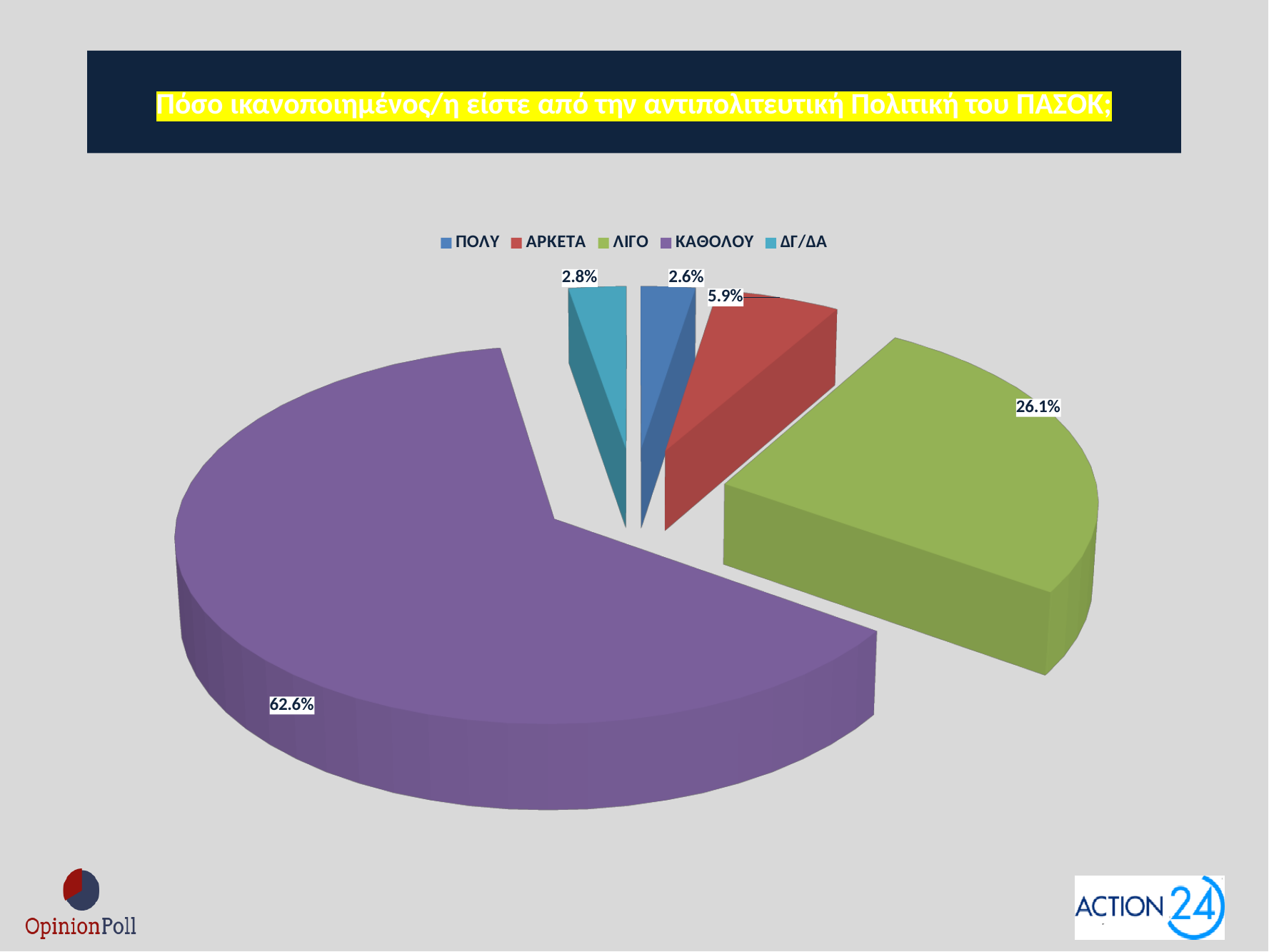
Which is larger, the share for ΑΡΚΕΤΑ or the share for ΔΓ/ΔΑ? ΑΡΚΕΤΑ What percentage of respondents answered ΔΓ/ΔΑ? 2.8% What kind of chart is shown on the slide? Pie chart Which response has the largest share of the pie? ΚΑΘΟΛΟΥ What percentage of respondents answered ΚΑΘΟΛΟΥ? 62.6% What percentage of respondents answered ΛΙΓΟ? 26.1% What is the difference in percentage points between ΚΑΘΟΛΟΥ and ΛΙΓΟ? 36.5 What percentage of respondents answered ΠΟΛΥ? 2.6% How many slices does the pie chart have? 5 What colour is the ΛΙΓΟ slice in the pie chart? Green Which response has the smallest share of the pie? ΠΟΛΥ What percentage of respondents answered ΑΡΚΕΤΑ? 5.9%